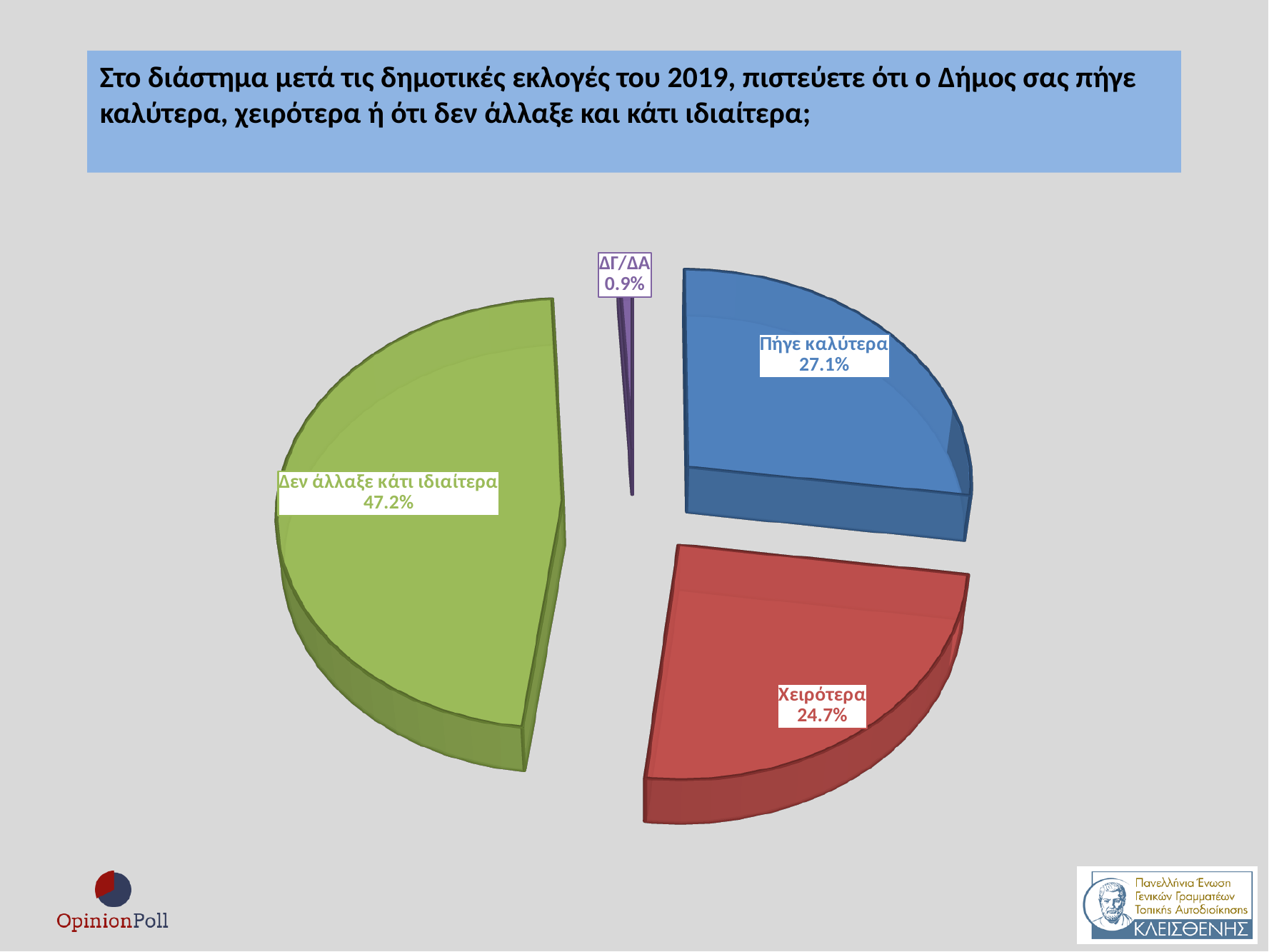
What colour is the slice for "Χειρότερα"? Red How many slices does the pie chart have? 4 What percentage of respondents answered "Χειρότερα"? 24.7% What is the difference in percentage points between "Πήγε καλύτερα" and "Χειρότερα"? 2.4 What percentage of respondents answered "Δεν άλλαξε κάτι ιδιαίτερα"? 47.2% What percentage of respondents answered "ΔΓ/ΔΑ"? 0.9% Which response has the largest share of the pie? Δεν άλλαξε κάτι ιδιαίτερα What is the difference in percentage points between "Δεν άλλαξε κάτι ιδιαίτερα" and "Πήγε καλύτερα"? 20.1 Which response has the smallest share of the pie? ΔΓ/ΔΑ What kind of chart is shown on the slide? Pie chart What percentage of respondents answered "Πήγε καλύτερα"? 27.1% Which is larger: the share for "Πήγε καλύτερα" or the share for "Χειρότερα"? Πήγε καλύτερα